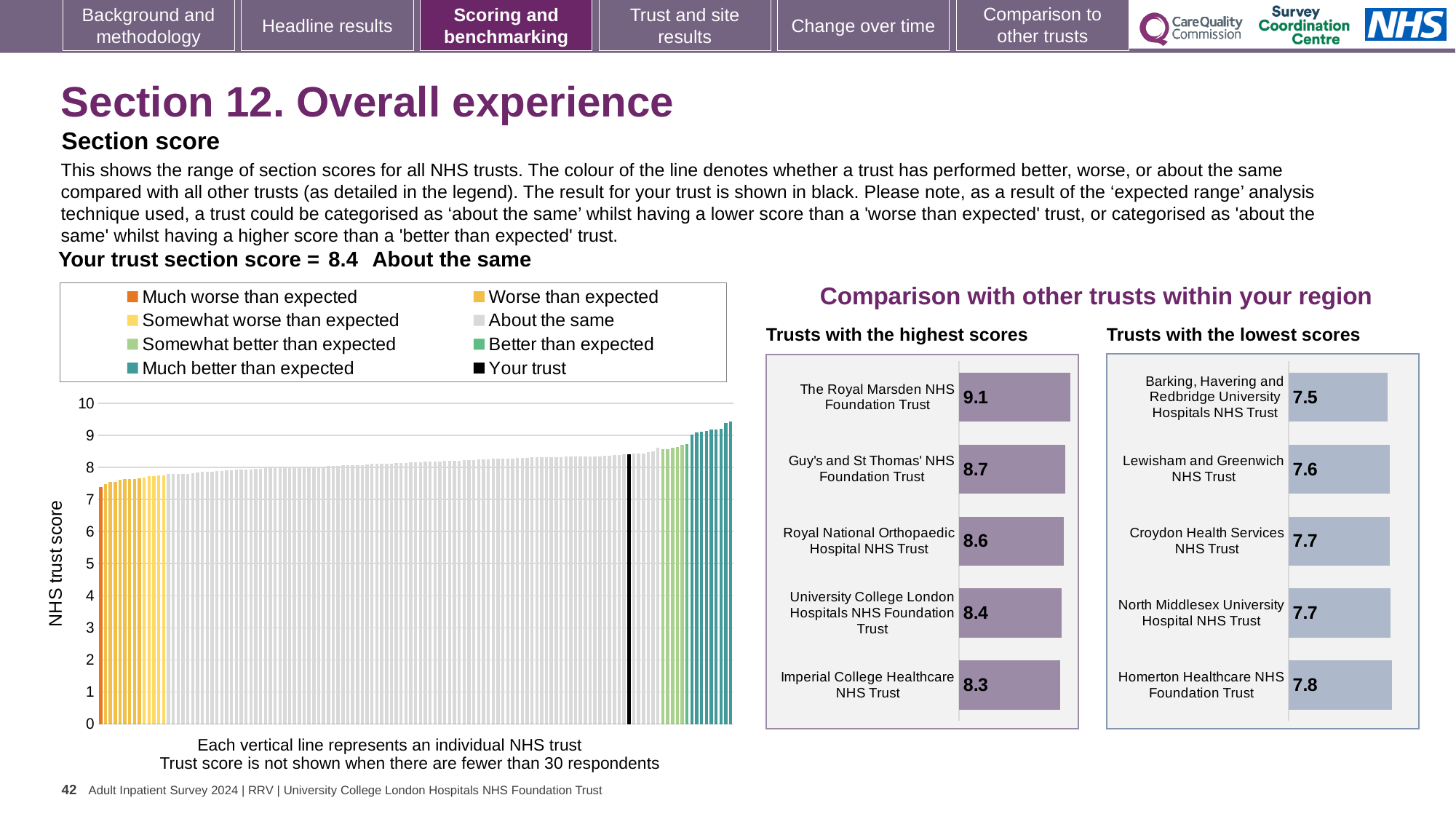
In the 'Trusts with the highest scores' chart, what is the difference between the scores of The Royal Marsden NHS Foundation Trust and Guy's and St Thomas' NHS Foundation Trust? 0.4 How many entries does the legend of the main section score chart on the left list? 8 In the 'Trusts with the lowest scores' chart, what is the score for Barking, Havering and Redbridge University Hospitals NHS Trust? 7.5 In the 'Trusts with the lowest scores' chart, which has the larger score: Lewisham and Greenwich NHS Trust or Homerton Healthcare NHS Foundation Trust? Homerton Healthcare NHS Foundation Trust In the 'Trusts with the lowest scores' chart, which trust has the highest score? Homerton Healthcare NHS Foundation Trust In the 'Trusts with the highest scores' chart, what is the score for The Royal Marsden NHS Foundation Trust? 9.1 How many trusts are shown in the 'Trusts with the lowest scores' chart? 5 In the main section score chart on the left, is the value of the leftmost (orange) bar greater or less than 8? less In the main section score chart on the left, what is the score for your trust (the black bar)? 8.4 In the 'Trusts with the highest scores' chart, which trust has the lowest score? Imperial College Healthcare NHS Trust In the 'Trusts with the highest scores' chart, what is the score for Imperial College Healthcare NHS Trust? 8.3 In the main section score chart on the left, do the bar values rise or fall from left to right along the x axis? rise